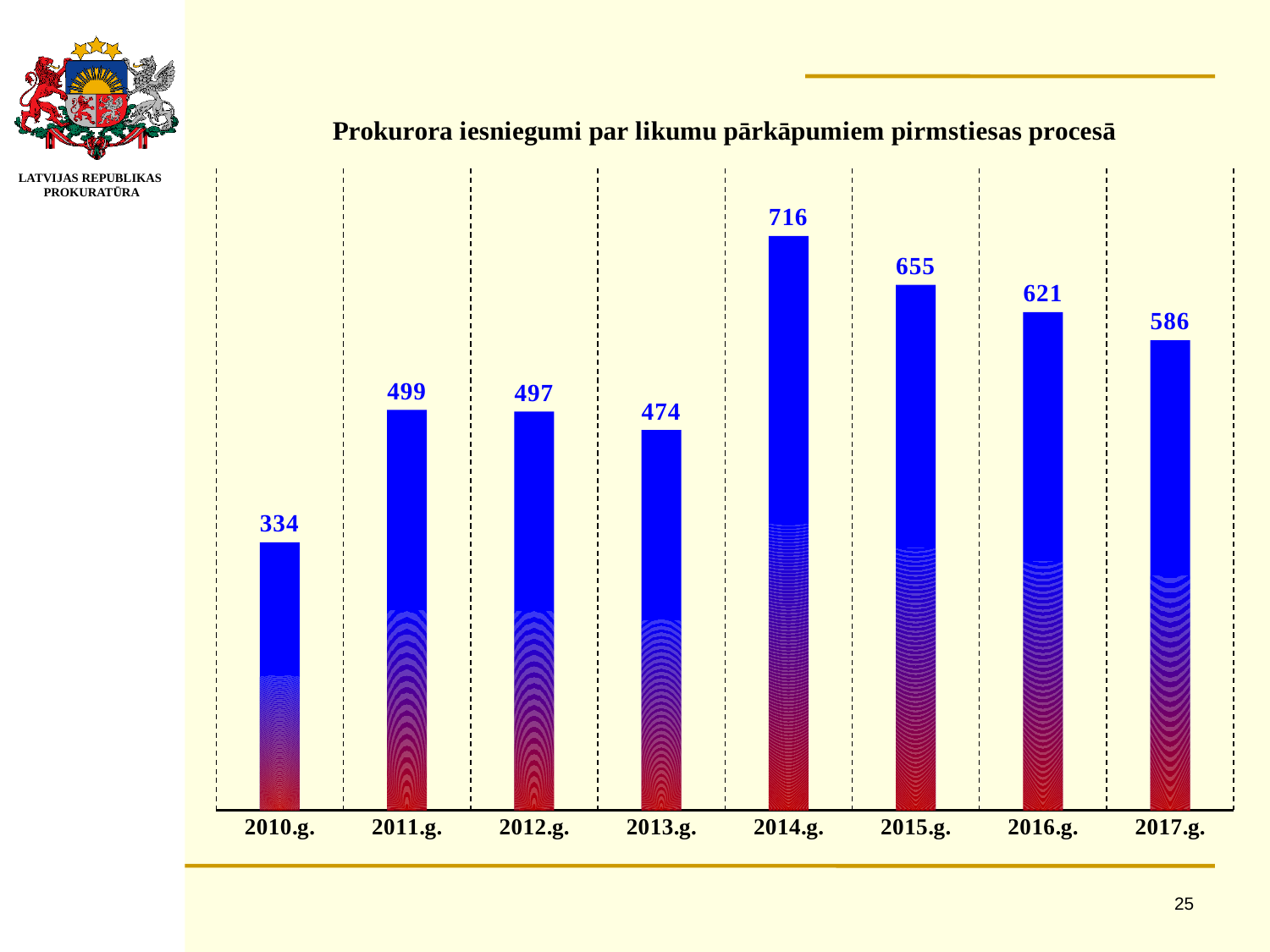
What is the difference between the values for 2014.g. and 2015.g.? 61 Which is larger, the value for 2013.g. or the value for 2016.g.? 2016.g. How many years are shown on the x axis? 8 What is the title of the chart? Prokurora iesniegumi par likumu pārkāpumiem pirmstiesas procesā What is the value for 2014.g.? 716 What kind of chart is shown on the slide? bar chart What is the value for 2010.g.? 334 Do the values rise or fall from 2014.g. to 2017.g.? fall Which year has the lowest value? 2010.g. What is the difference between the values for 2011.g. and 2010.g.? 165 Which year has the highest value? 2014.g. What is the value for 2017.g.? 586